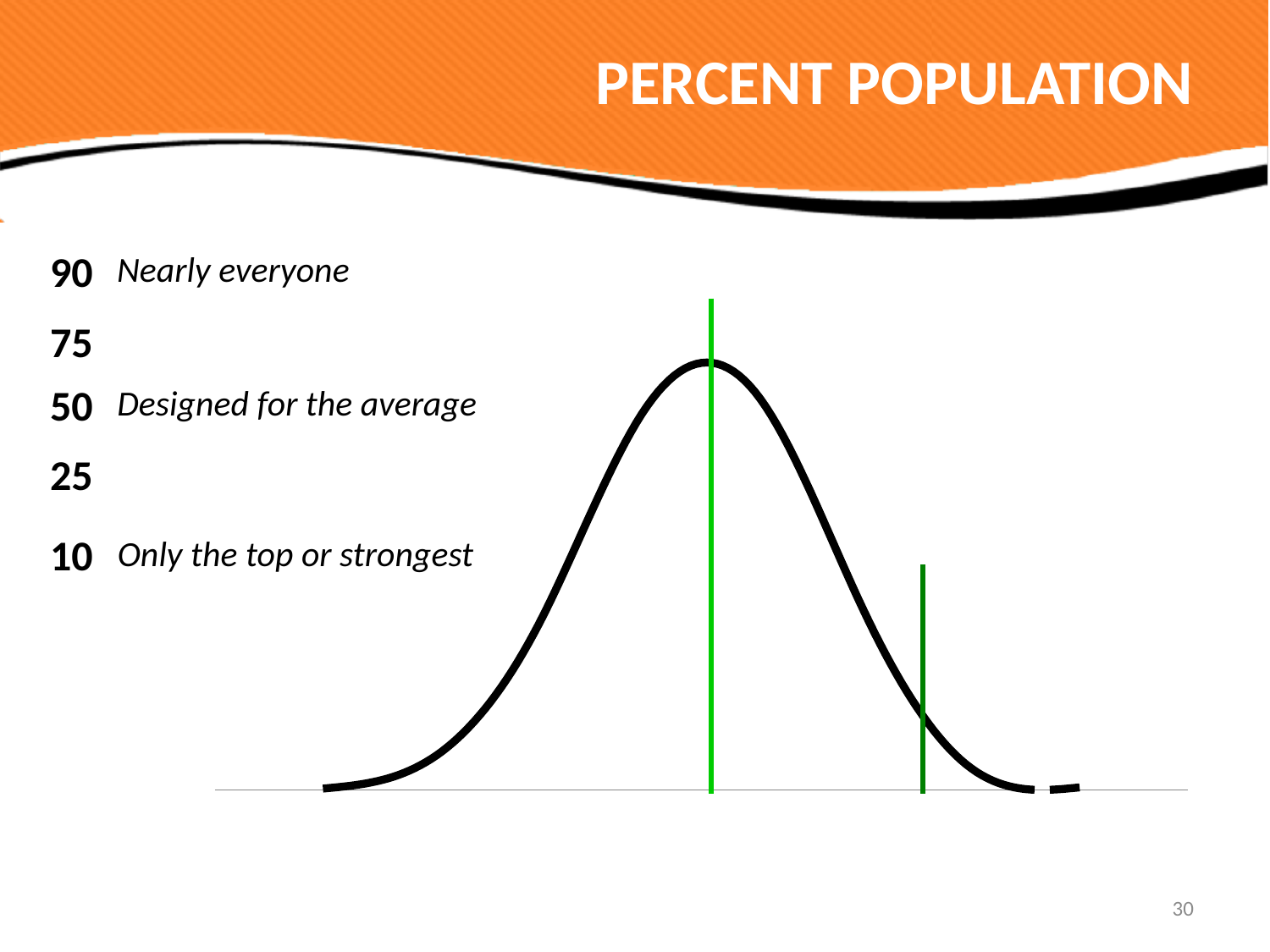
What is the highest percentage value listed on the slide? 90 What label appears next to the value 50? Designed for the average What is the title of the slide containing the chart? PERCENT POPULATION Does the curve rise or fall moving from the left end toward the centre? rise How many percentage values are listed on the left side of the slide? 5 What label appears next to the value 10? Only the top or strongest What label appears next to the value 90? Nearly everyone What is the lowest percentage value listed on the slide? 10 What kind of chart is shown on the slide? line chart (bell curve) Which of the two green vertical lines is taller, the left one or the right one? the left one How many green vertical lines are drawn on the curve? 2